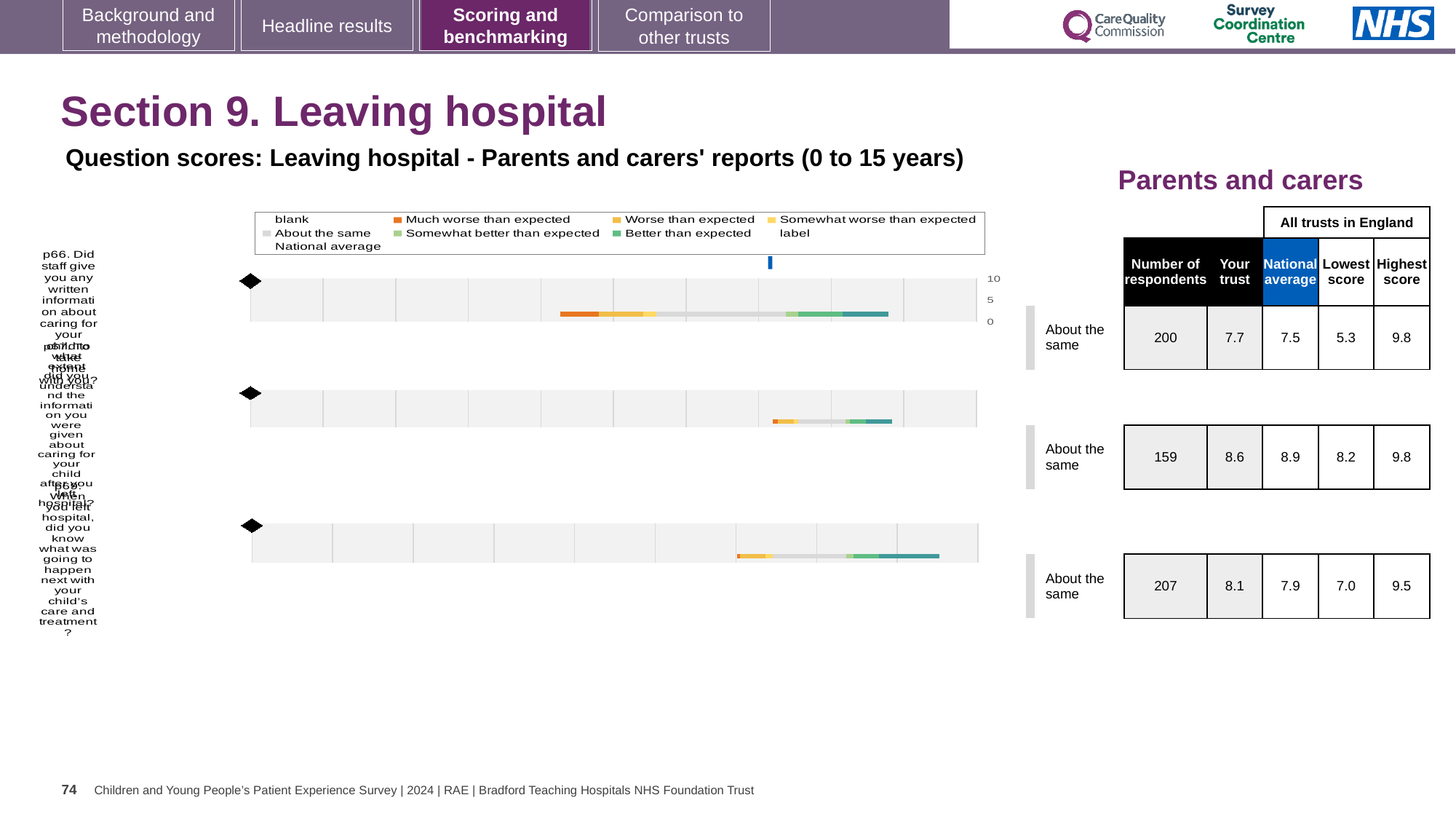
How many question rows (charts) are shown on the slide? 3 For the bottom chart (p68), what is the difference between the highest score and the lowest score across all trusts in England? 2.5 For the middle chart, what is the national average score shown in the table? 8.9 In the legend, what colour represents 'Much worse than expected'? Orange Which of the three question rows has the lowest 'Lowest score' value? The top row, p66 (5.3) For the bottom chart (p68, knowing what was going to happen next), how many respondents are listed? 207 What kind of chart is used to show the question scores on this slide? Bar chart What benchmark category is shown next to each of the three charts? About the same Which of the three question rows has the highest 'Your trust' score? The middle row (8.6) For the top chart (p66), which is larger: the 'Your trust' score or the national average? Your trust For the top chart (p66, written information about caring for your child at home), what is the 'Your trust' score in the table? 7.7 For the top chart (p66), what is the highest score among all trusts in England? 9.8